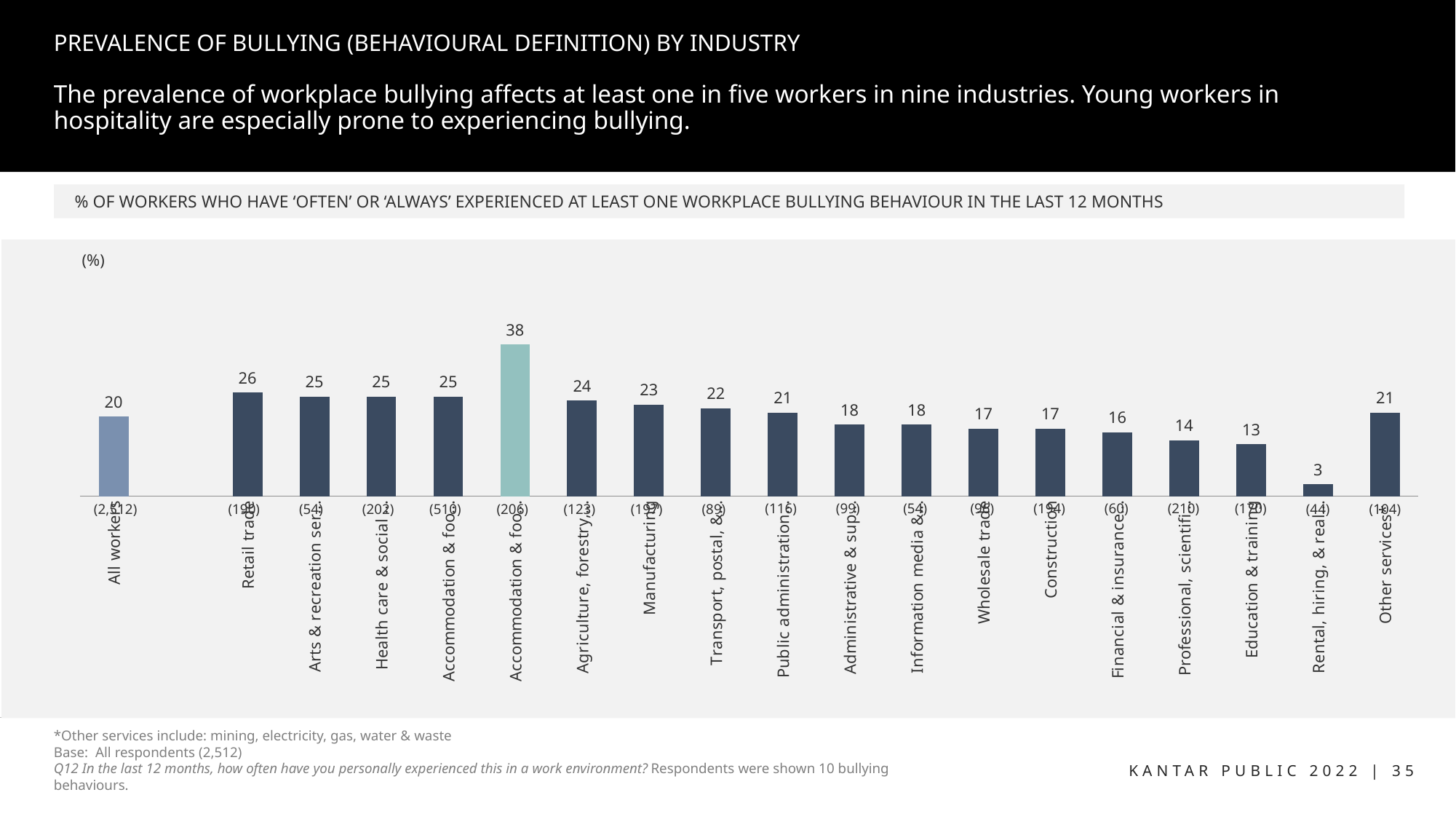
What is the value for All workers? 20 How many bars are shown on the chart? 19 Which category has the lowest value? Rental, hiring, & real What is the value for Education & training? 13 What is the highest value shown on the chart? 38 What is the difference between the values for Retail trade and All workers? 6 What is the value for Retail trade? 26 What is the value for Construction? 17 What is the value for Manufacturing? 23 What is the value for Other services? 21 What kind of chart is shown on the slide? Bar chart Which is larger, the value for Wholesale trade or the value for Financial & insurance? Wholesale trade